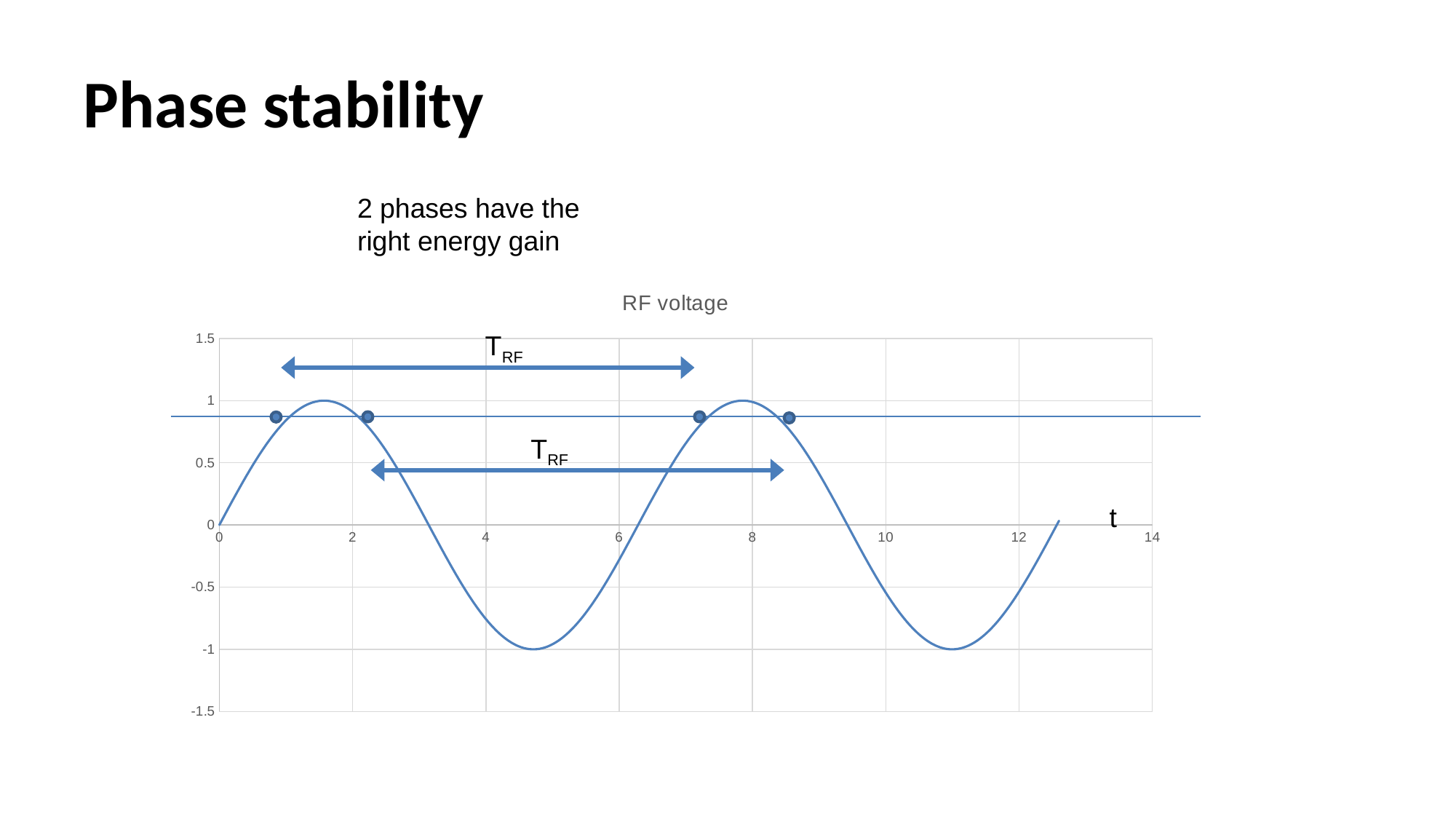
How many highlighted dots are marked on the RF voltage curve? 4 Is the value of the RF voltage curve at t = 11 greater or less than -0.5? less Is the value of the RF voltage curve at t = 2 greater or less than 0.5? greater Does the RF voltage curve rise or fall between t = 2 and t = 4? fall What is the highest value labelled on the vertical axis of the RF voltage chart? 1.5 What kind of chart is shown on the slide? line chart What is the minimum value the RF voltage curve reaches? -1 What is the maximum value the RF voltage curve reaches? 1 Does the RF voltage curve rise or fall between t = 6 and t = 8? rise What is the title of the chart? RF voltage Is the value of the RF voltage curve at t = 4 greater or less than 0? less